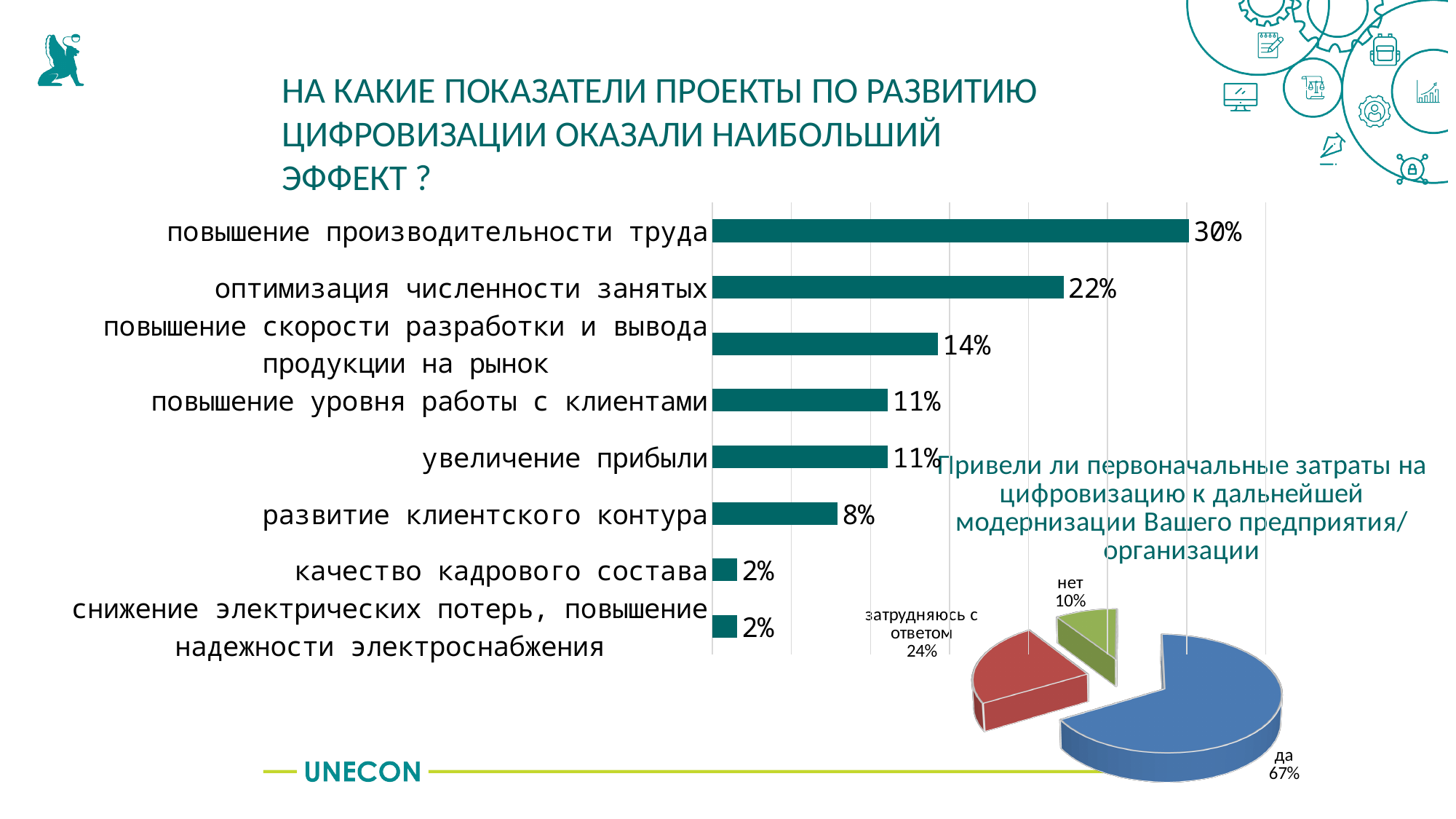
In the bar chart on the left, which category has the highest value? повышение производительности труда How many categories are shown in the bar chart on the left? 8 In the bar chart on the left, what is the value for 'оптимизация численности занятых'? 22% In the bar chart on the left, which is larger: 'повышение скорости разработки и вывода продукции на рынок' or 'повышение уровня работы с клиентами'? повышение скорости разработки и вывода продукции на рынок What type of chart is shown on the left of the slide? bar chart In the pie chart on the right, which answer has the smallest share? нет How many slices does the pie chart on the right have? 3 In the bar chart on the left, what is the difference between 'повышение производительности труда' and 'оптимизация численности занятых'? 8% In the pie chart on the right, what share of respondents answered 'нет'? 10% In the bar chart on the left, what is the value for 'развитие клиентского контура'? 8% In the bar chart on the left, what is the value for 'повышение производительности труда'? 30% In the pie chart on the right, what share of respondents answered 'да'? 67%